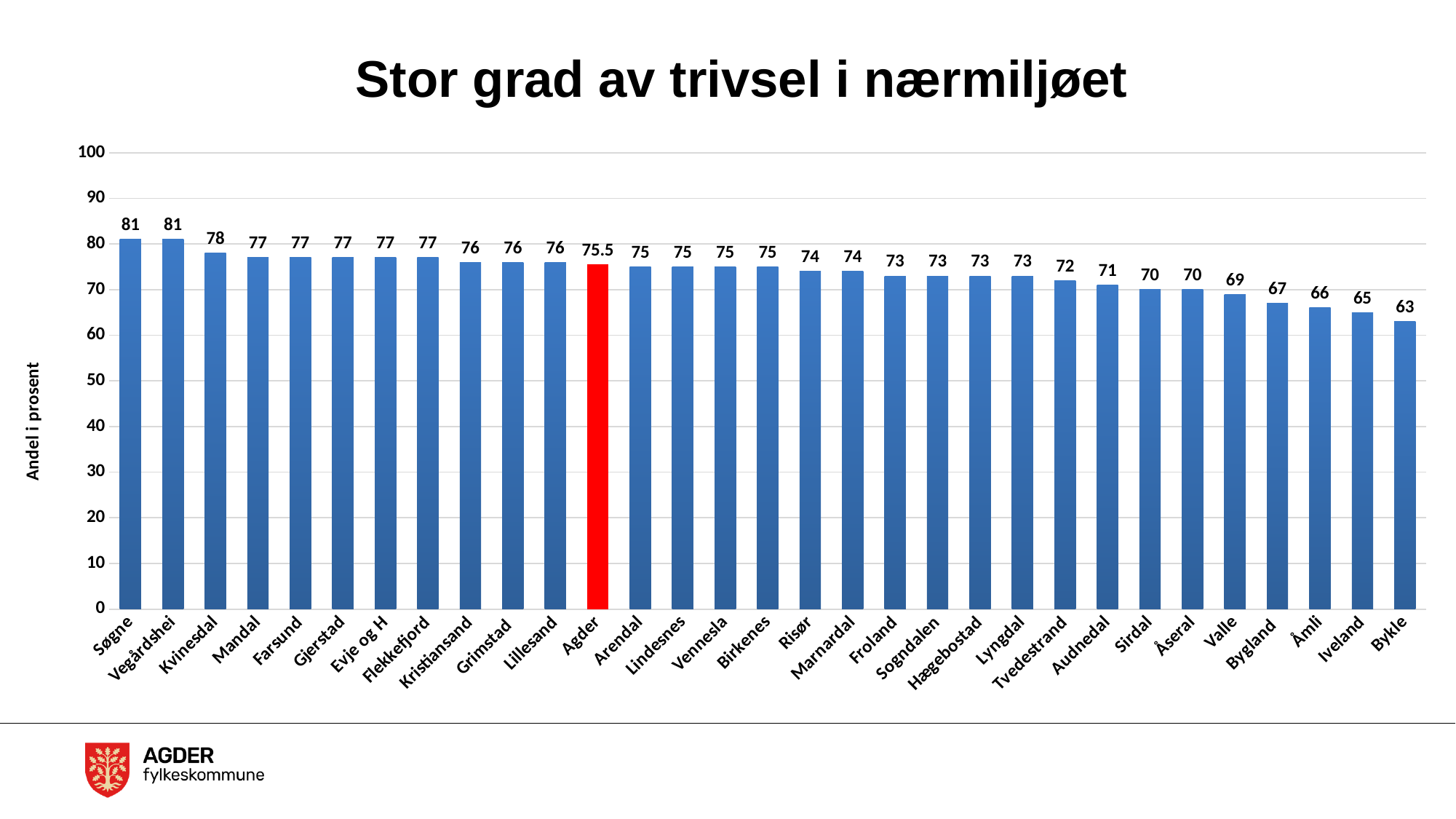
How many categories are shown on the x axis? 31 What is the difference between the values for Kvinesdal and Valle? 9 What is the difference between the values for Søgne and Bykle? 18 What is the value for Kristiansand? 76 Which is larger, the value for Arendal or the value for Sirdal? Arendal What is the title of the chart? Stor grad av trivsel i nærmiljøet What is the value for Bygland? 67 Which category has the lowest value? Bykle What is the value for Agder? 75.5 What kind of chart is shown on the slide? bar chart Is the value for Iveland greater or less than 70? less What is the value for Tvedestrand? 72